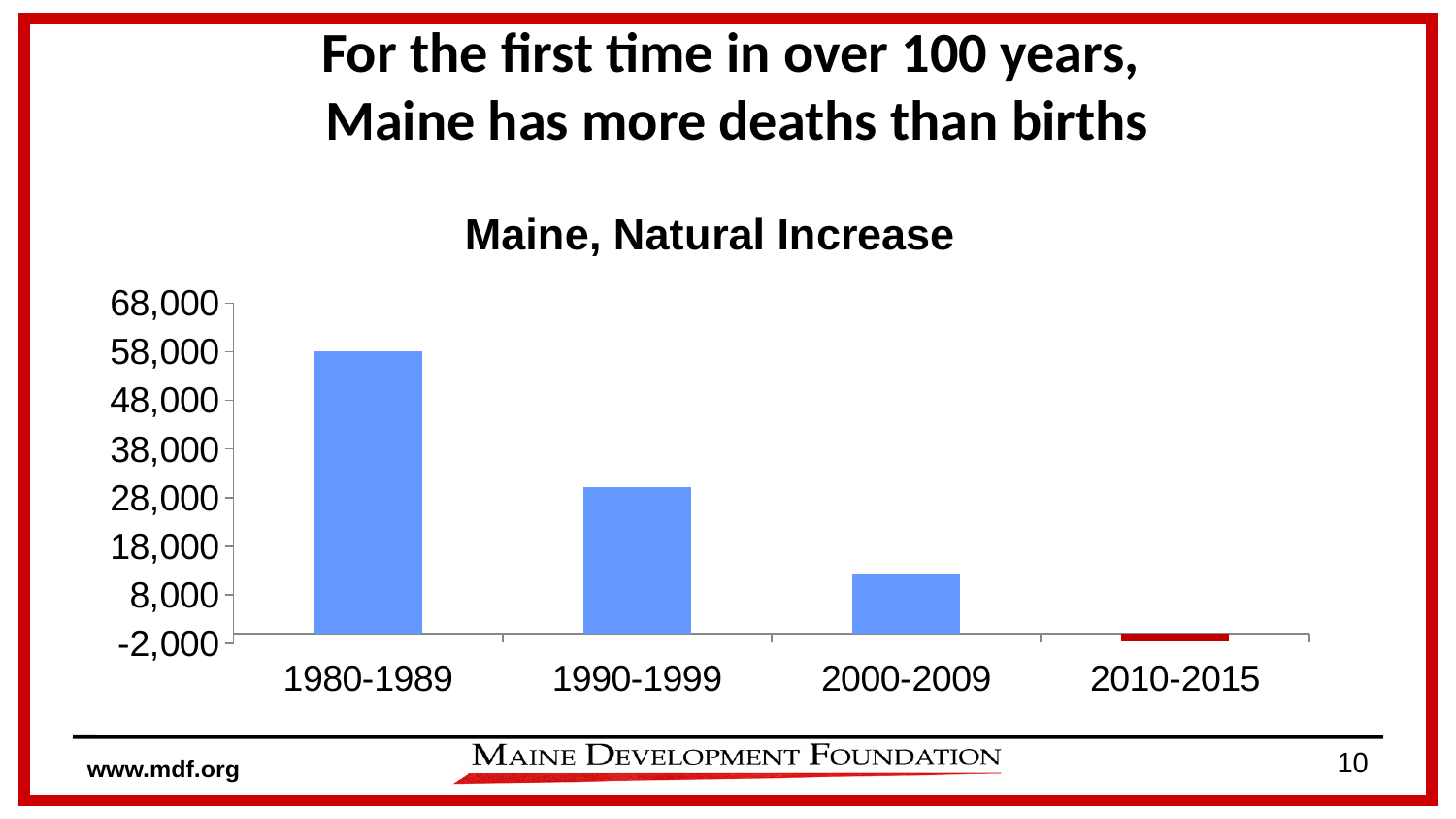
Which period has the lowest natural increase? 2010-2015 Do the values rise or fall from 1980-1989 to 2010-2015? fall What is the title of the chart? Maine, Natural Increase How many time periods are shown on the x axis of the chart? 4 Is the value for 2010-2015 greater or less than 8,000? less Is the value for 2000-2009 greater or less than 18,000? less Which period has the highest natural increase? 1980-1989 Is the value for 2000-2009 greater or less than 8,000? greater What type of chart is shown on the slide? bar chart Which is larger, the value for 1990-1999 or the value for 2000-2009? 1990-1999 What colour is the bar for 2010-2015? red